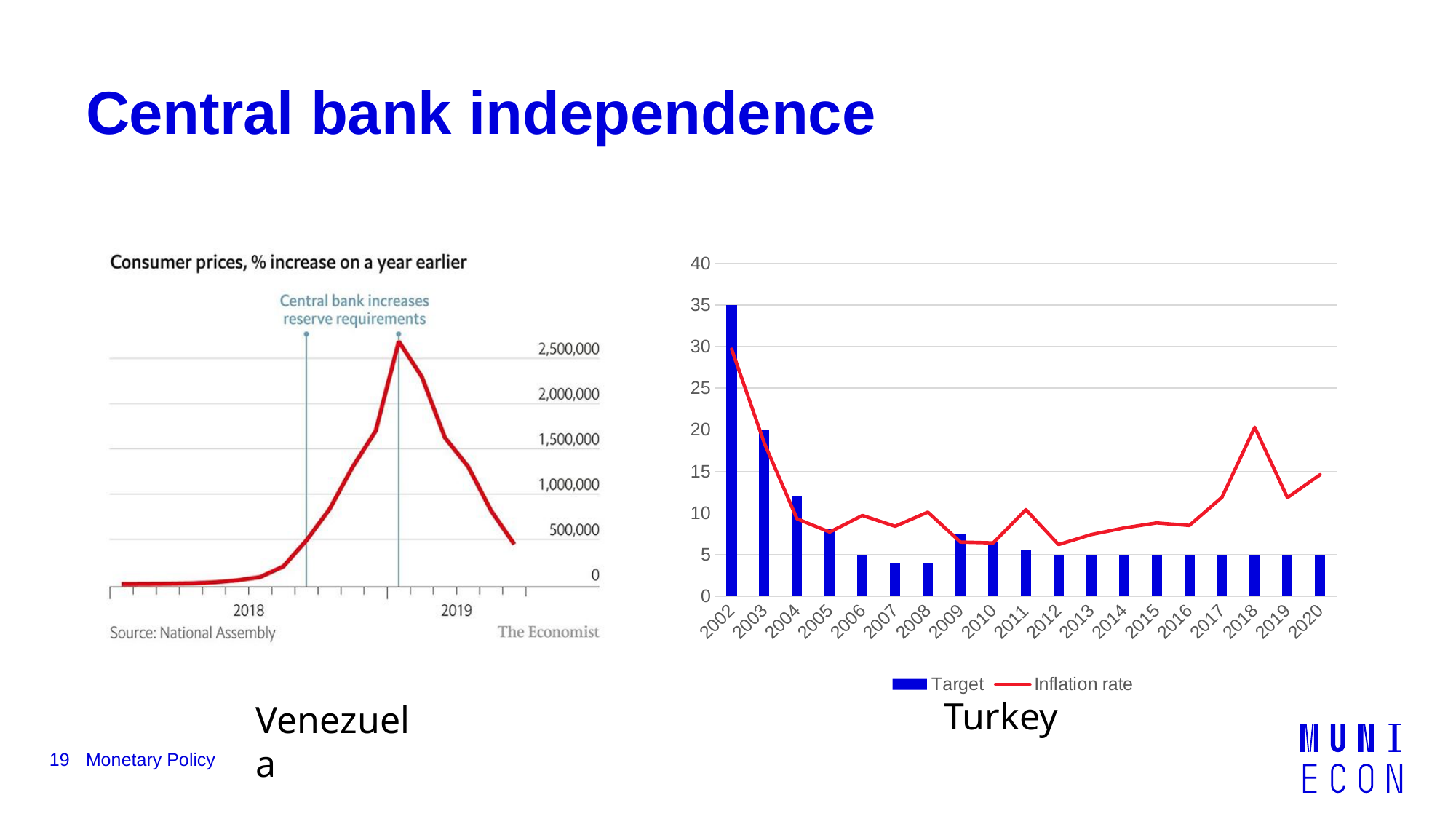
What kind of chart is the Venezuela chart on the left? Line chart In the Venezuela chart on the left, is the peak value of consumer price growth greater or less than 2,000,000? greater What is the title of the Venezuela chart on the left? Consumer prices, % increase on a year earlier In the Turkey chart on the right, what is the Target value for 2002? 35 In the Turkey chart on the right, is the Inflation rate for 2018 greater or less than 15? greater In the Turkey chart on the right, which year has the highest Target value? 2002 In the Venezuela chart on the left, what event do the two vertical markers annotate? Central bank increases reserve requirements How many series does the legend of the Turkey chart on the right list? 2 In the Turkey chart on the right, what is the Target value for 2003? 20 In the Turkey chart on the right, what is the Target value for 2020? 5 How many years are shown on the x axis of the Turkey chart on the right? 19 In the Turkey chart on the right, which is larger in 2018, the Target or the Inflation rate? Inflation rate